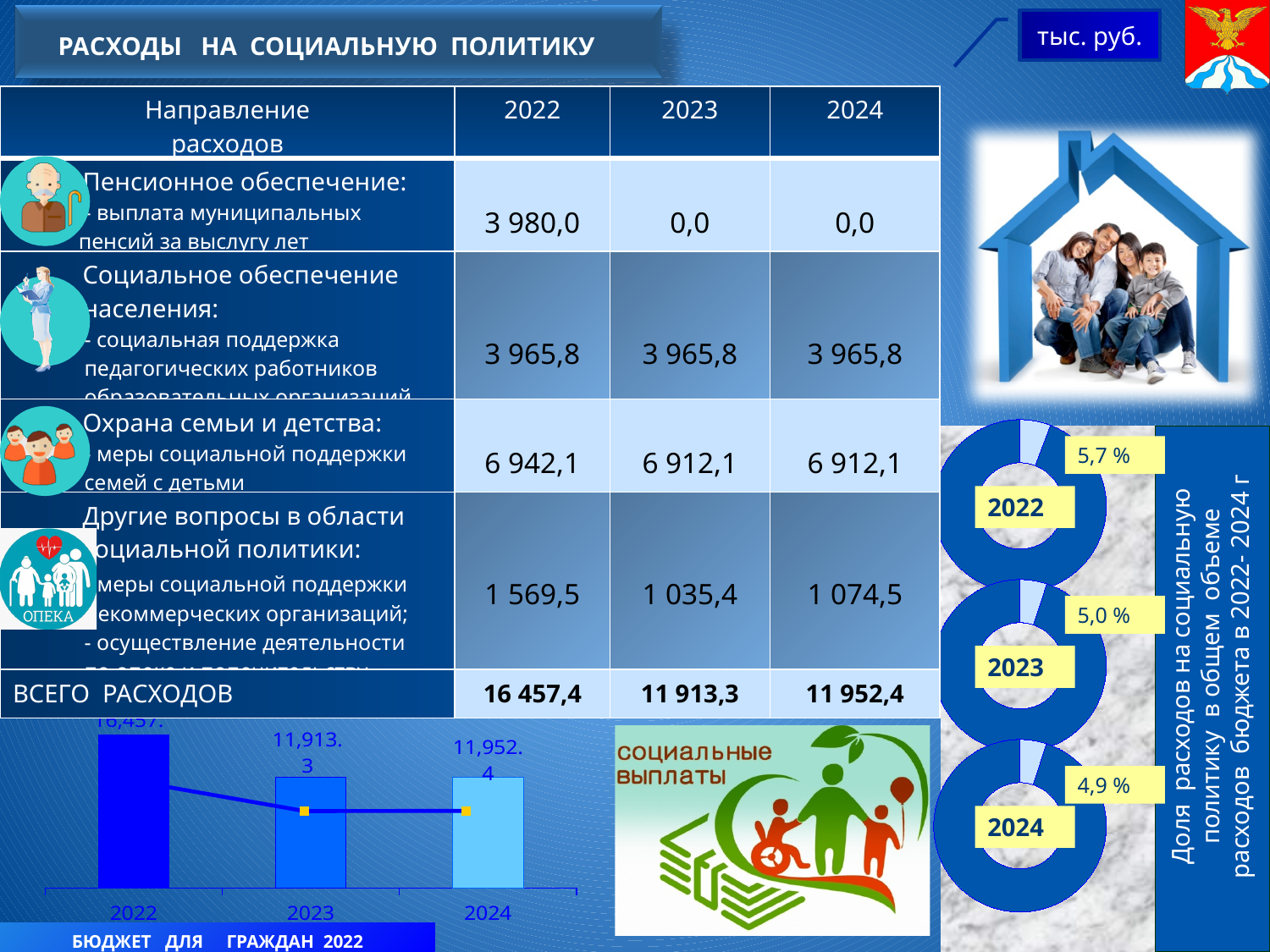
In the bar chart at the bottom left of the slide, what is the value shown for 2024? 11,952.4 Among the donut charts on the right of the slide, which year has the lowest share? 2024 In the bar chart at the bottom left of the slide, which year has the lowest value? 2023 In the donut charts on the right of the slide, what share of total budget expenditure is shown for 2022? 5,7 % What kind of chart is shown at the bottom left of the slide? bar chart How many years are shown on the x axis of the bar chart at the bottom left of the slide? 3 In the bar chart at the bottom left of the slide, what is the difference between the values for 2024 and 2023? 39.1 In the bar chart at the bottom left of the slide, which is larger, the value for 2023 or the value for 2024? 2024 In the bar chart at the bottom left of the slide, which year has the highest bar? 2022 In the bar chart at the bottom left of the slide, what is the value shown for 2023? 11,913.3 In the donut charts on the right of the slide, what share is shown for 2024? 4,9 % In the bar chart at the bottom left of the slide, does the value rise or fall from 2022 to 2023? fall